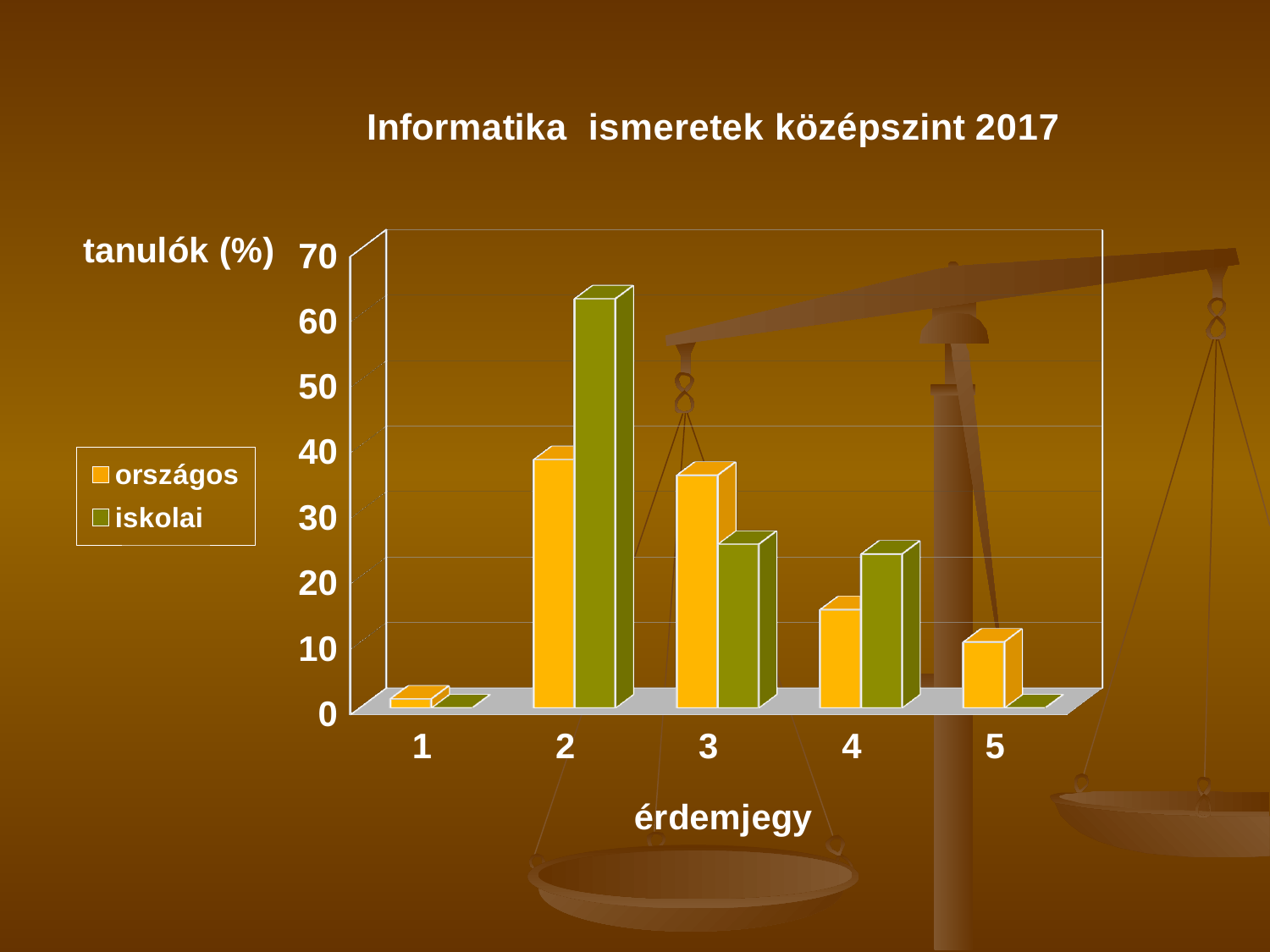
For which érdemjegy is the országos value lowest? 1 Do the országos values rise or fall from érdemjegy 2 to érdemjegy 5? fall What is the title of the chart? Informatika ismeretek középszint 2017 Is the iskolai value for érdemjegy 2 greater or less than 50? greater How many series does the legend list? 2 For which érdemjegy is the iskolai value highest? 2 How many categories (érdemjegy values) are shown on the x axis? 5 What is the label of the vertical axis? tanulók (%) For érdemjegy 2, which series has the larger value, országos or iskolai? iskolai Is the országos value for érdemjegy 4 greater or less than 20? less For érdemjegy 3, which series has the larger value, országos or iskolai? országos What kind of chart is shown on the slide? bar chart